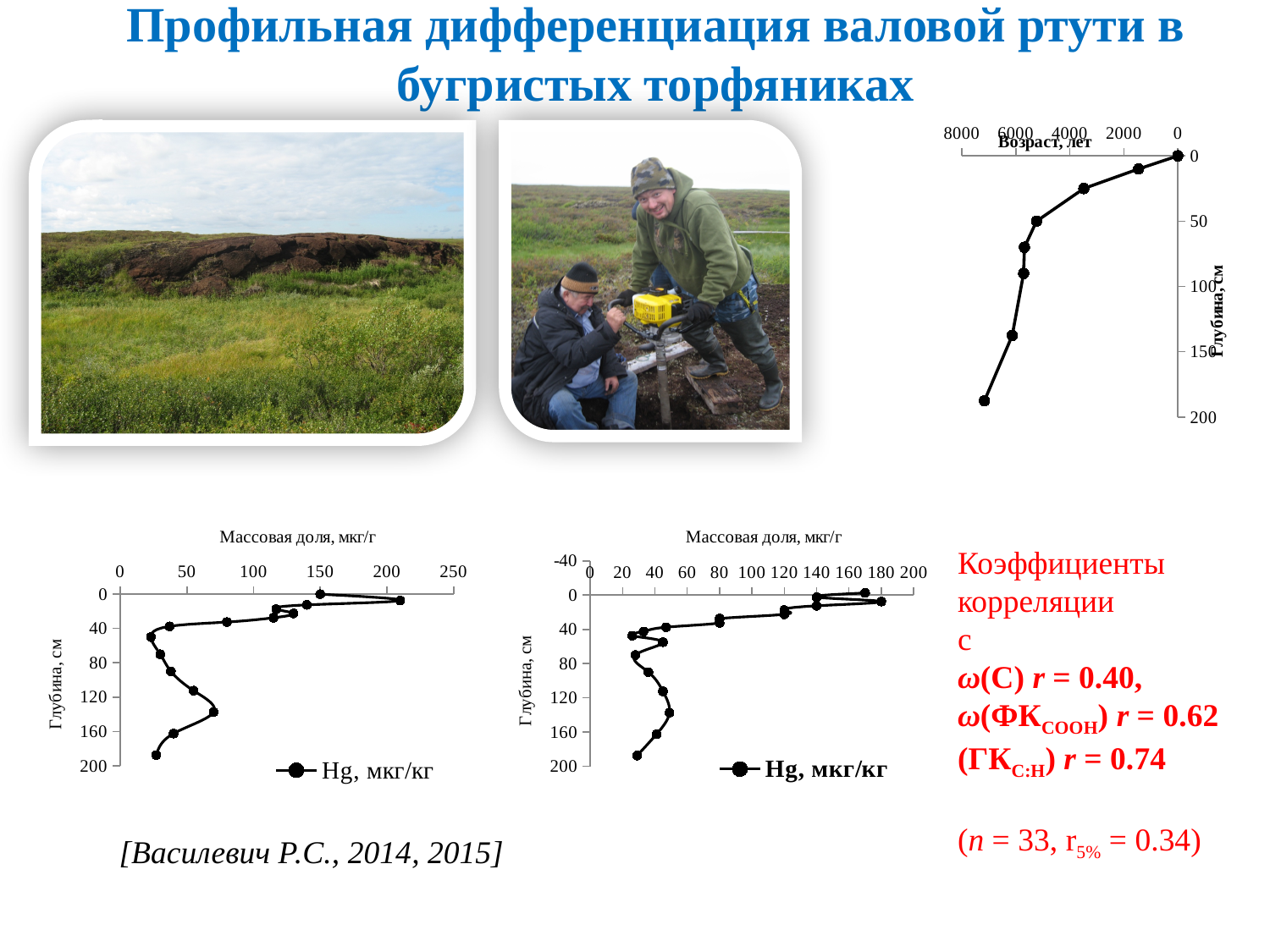
In the top-right chart (Возраст, лет), is the age at the deepest point (near 190 cm) greater or less than 6000 years? greater What kind of chart is the bottom-left chart? line chart How many series does the legend of the bottom-left chart list? 1 In the bottom-left chart, is the highest value in the profile greater or less than 150? greater In the top-right chart (Возраст, лет), is the age at depth 50 cm greater or less than 4000 years? greater What is the legend entry of the bottom-middle chart? Hg, мкг/кг What is the x-axis title of the bottom-left chart? Массовая доля, мкг/г In the top-right chart, does the age increase or decrease as depth increases from 0 to 200 cm? increase